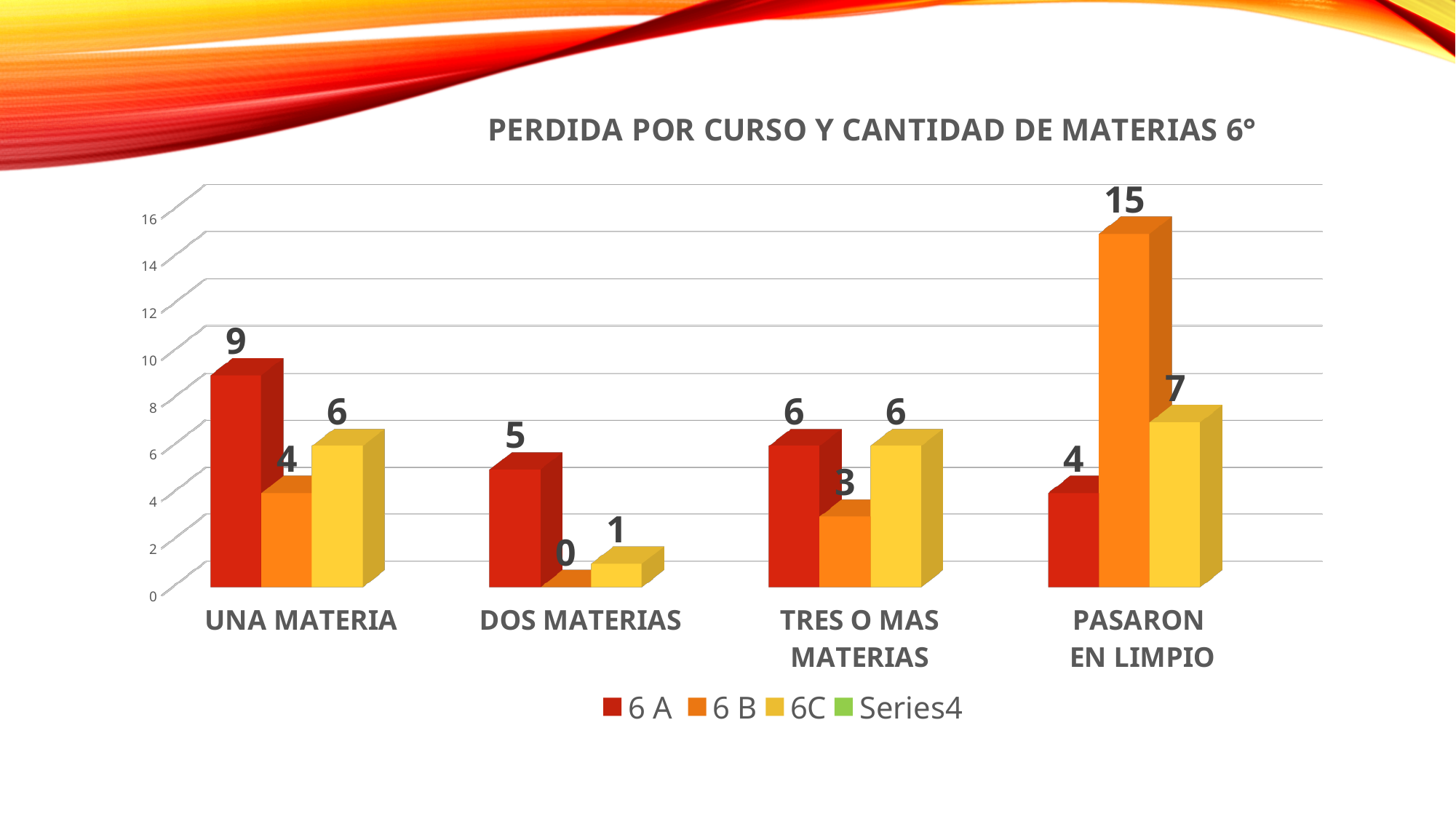
What is the value for 6 B in the DOS MATERIAS category? 0 Which category has the highest value for the 6 B series? PASARON EN LIMPIO What kind of chart is shown on the slide? Bar chart What is the title of the chart? PERDIDA POR CURSO Y CANTIDAD DE MATERIAS 6° What is the difference between the 6 B and 6 A values in the PASARON EN LIMPIO category? 11 How many series does the legend list? 4 What is the value for 6C in the DOS MATERIAS category? 1 How many categories are shown on the x axis? 4 In the UNA MATERIA category, which is larger, the value for 6 A or the value for 6C? 6 A What is the value for 6 B in the PASARON EN LIMPIO category? 15 Which category has the lowest value for the 6 A series? PASARON EN LIMPIO What is the value for 6 A in the UNA MATERIA category? 9